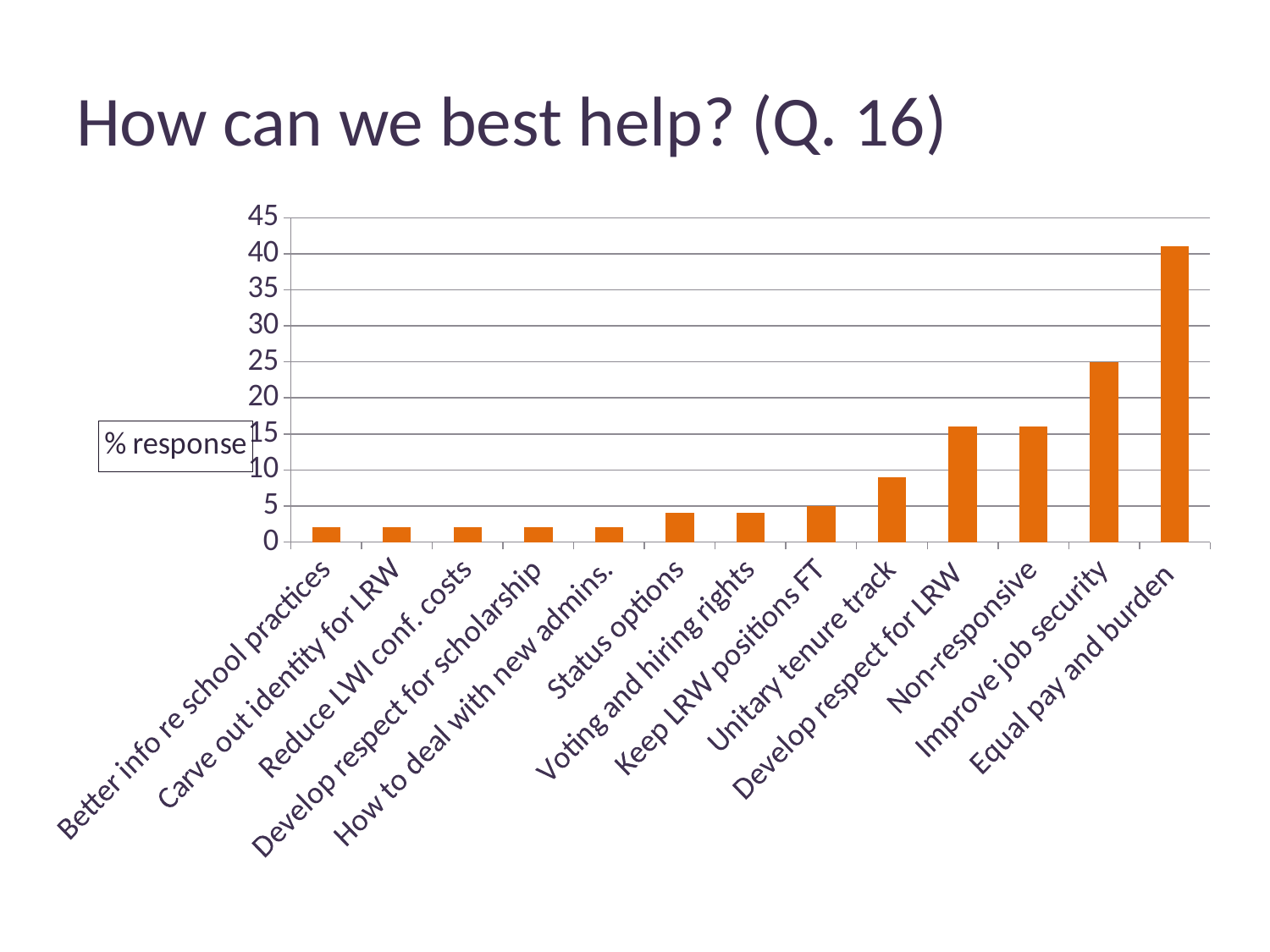
Which is larger, the value for Improve job security or the value for Non-responsive? Improve job security Is the value for Status options greater or less than 5? less Is the value for Non-responsive greater or less than 15? greater Which category has the highest value? Equal pay and burden Is the value for Unitary tenure track greater or less than 10? less Do the values generally rise or fall moving from left to right along the x axis? rise Which is larger, the value for Unitary tenure track or the value for Voting and hiring rights? Unitary tenure track What kind of chart is shown on the slide? bar chart How many categories are plotted on the x axis? 13